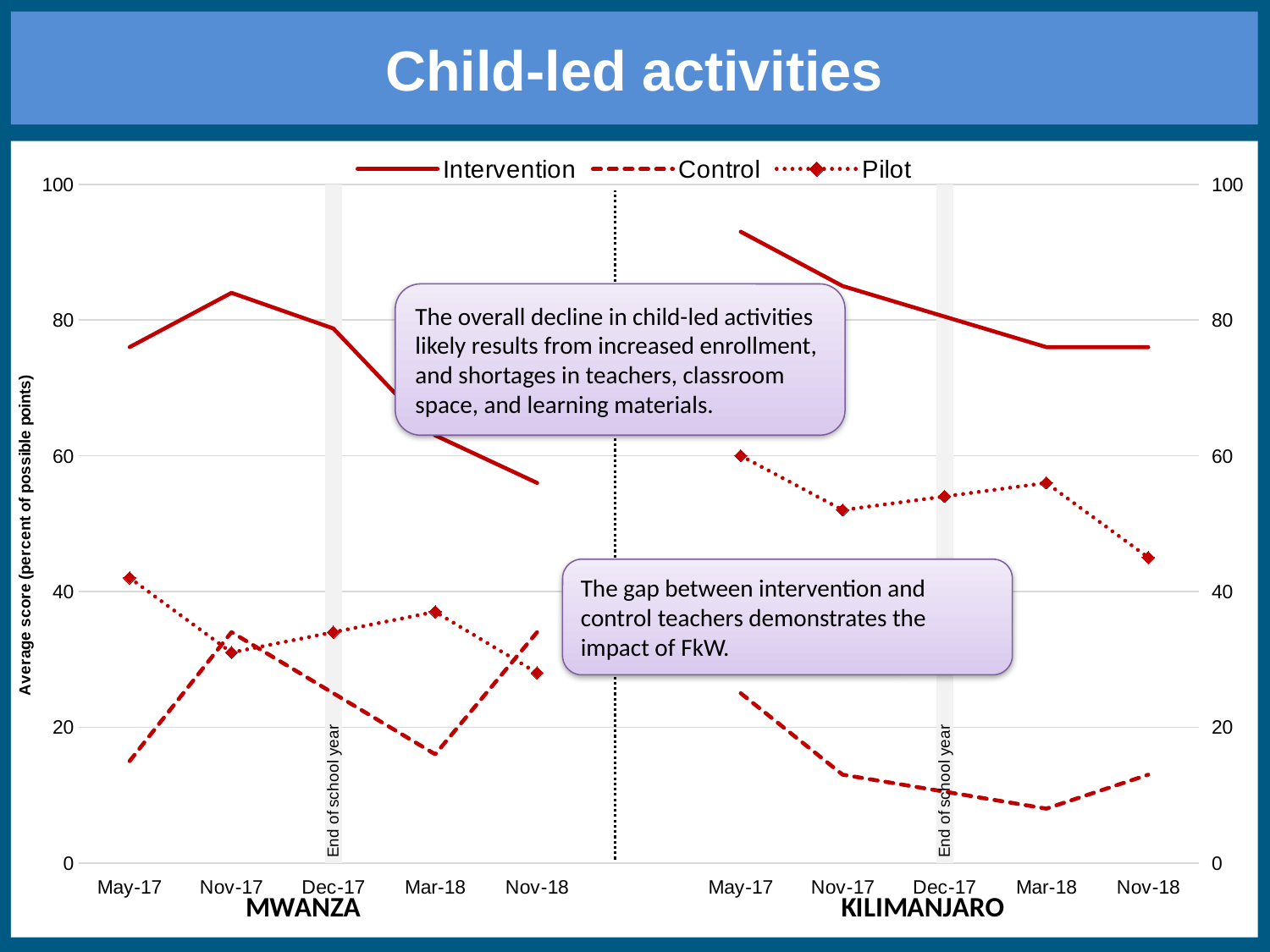
What are the three series named in the legend? Intervention, Control, Pilot Is the Intervention value for May-17 in MWANZA greater or less than 80? less Is the Control value for Mar-18 in KILIMANJARO greater or less than 20? less Is the Pilot value for Nov-18 in KILIMANJARO greater or less than 60? less How many time points are plotted for the MWANZA region? 5 At Nov-18 in KILIMANJARO, which series has the larger value, Intervention or Control? Intervention What kind of chart is shown on the slide? line chart At which region and time point does the Intervention series reach its highest value? KILIMANJARO, May-17 How many series does the legend list? 3 Does the Intervention series in KILIMANJARO rise or fall from May-17 to Nov-18? fall What is the title of the vertical axis? Average score (percent of possible points)